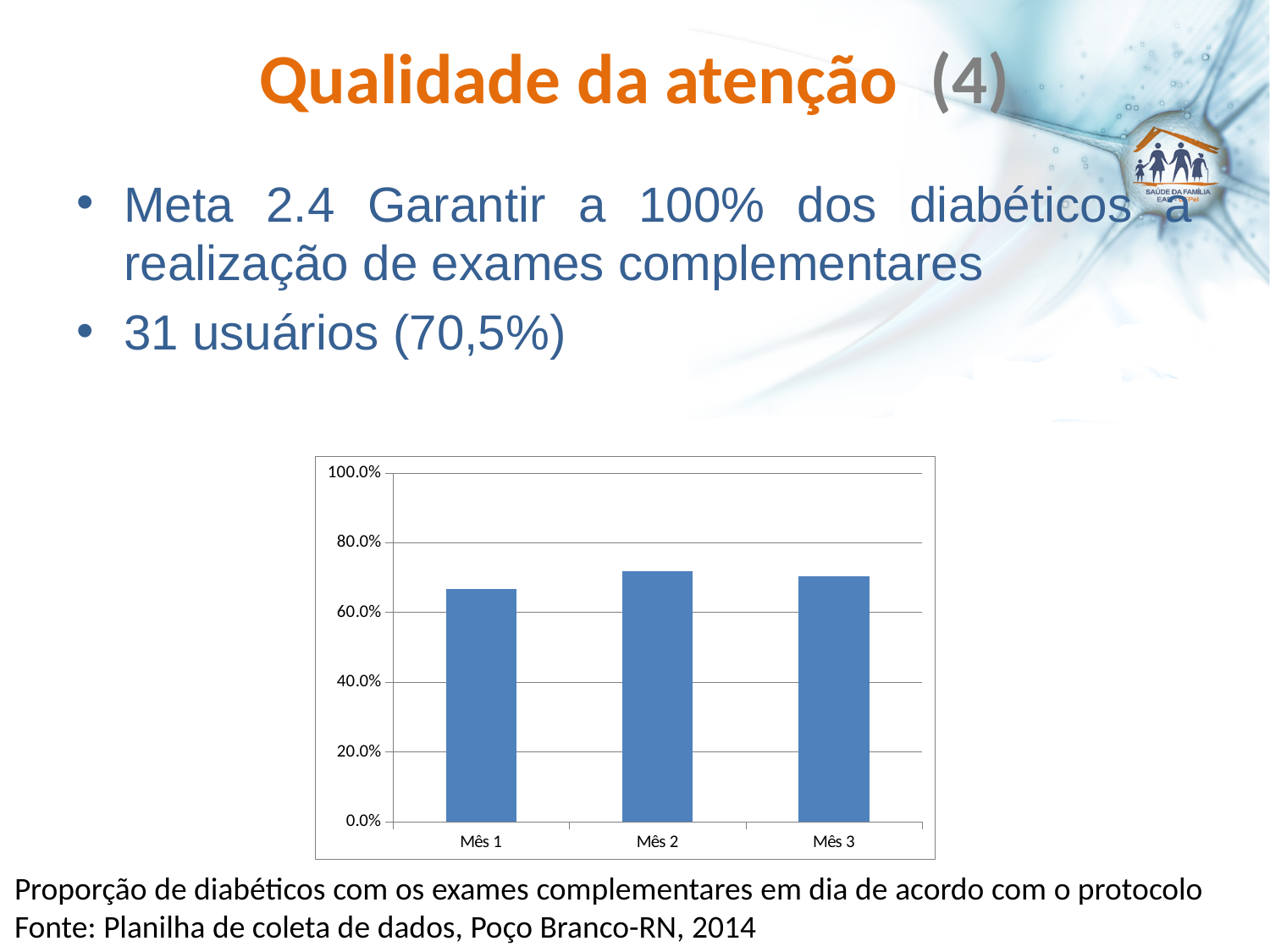
Is the value for Mês 3 greater or less than 80%? less Which is larger, the value for Mês 1 or the value for Mês 3? Mês 3 Which is larger, the value for Mês 1 or the value for Mês 2? Mês 2 What kind of chart is shown on the slide? bar chart How many bars (categories) does the chart show? 3 Is the value for Mês 3 greater or less than 60%? greater Does the value rise or fall from Mês 1 to Mês 2? rise What are the category labels on the chart's horizontal axis? Mês 1, Mês 2, Mês 3 Is the value for Mês 2 greater or less than 80%? less What is the highest value shown on the chart's vertical axis? 100.0% Which month has the lowest value in the chart? Mês 1